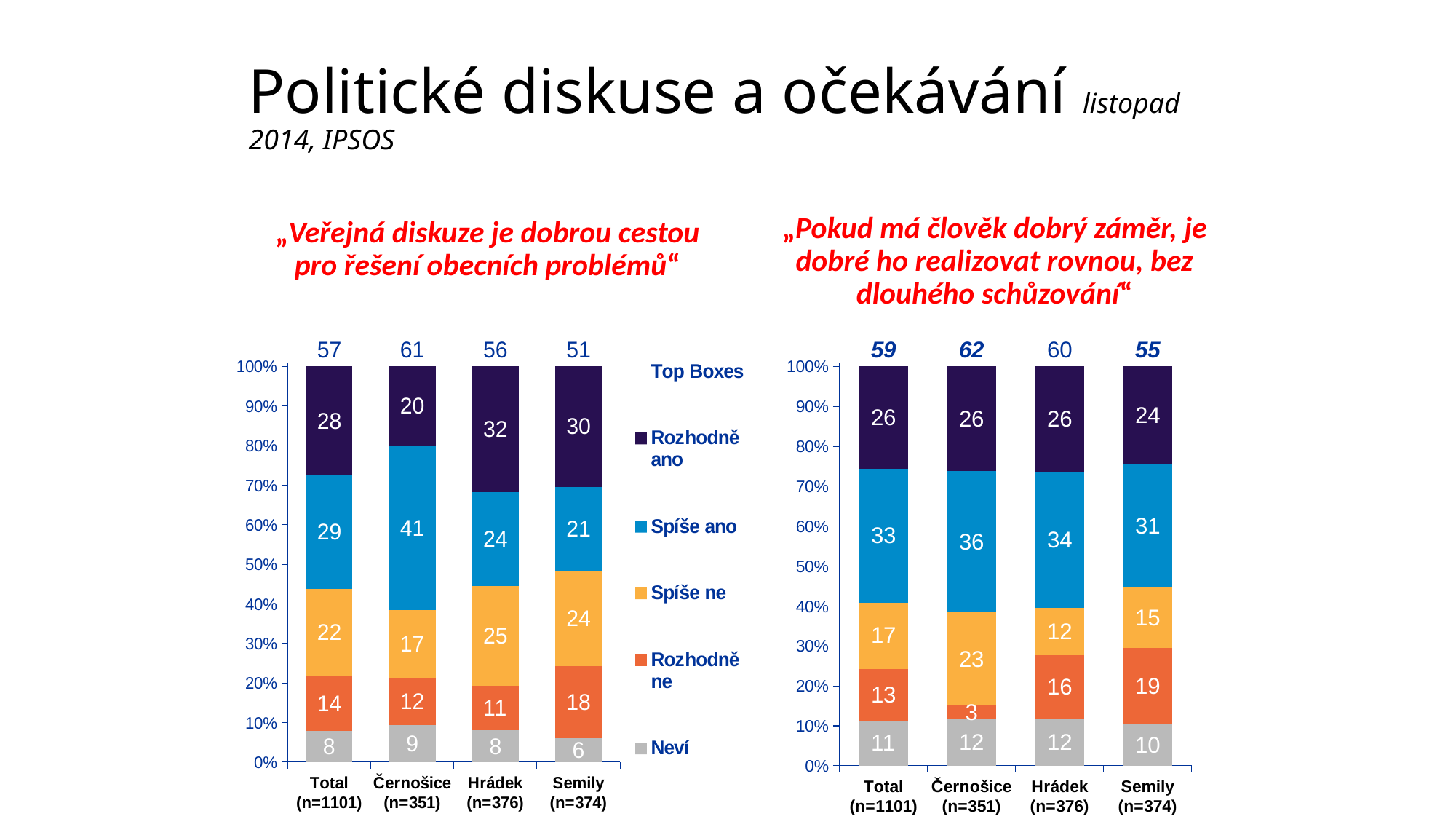
How many series does the legend list (excluding the "Top Boxes" label)? 5 In the right chart, what is the difference between the "Spíše ne" values for Černošice and Hrádek? 11 In the left chart ("Veřejná diskuze je dobrou cestou pro řešení obecních problémů"), what is the value of "Spíše ano" for Černošice? 41 In the right chart, what is the value of "Spíše ano" for Semily? 31 In the left chart, what is the sum of "Rozhodně ano" and "Spíše ano" for Total? 57 In the left chart, which is larger: "Rozhodně ano" for Hrádek or "Rozhodně ano" for Černošice? Hrádek In the right chart, which category has the highest Top Boxes value? Černošice In the left chart, what is the Top Boxes value shown above the Semily bar? 51 What type of chart is the right chart? Stacked bar chart In the left chart, which category has the lowest "Neví" value? Semily In the right chart ("Pokud má člověk dobrý záměr..."), what is the value of "Rozhodně ne" for Černošice? 3 How many categories are shown on the x axis of the left chart? 4